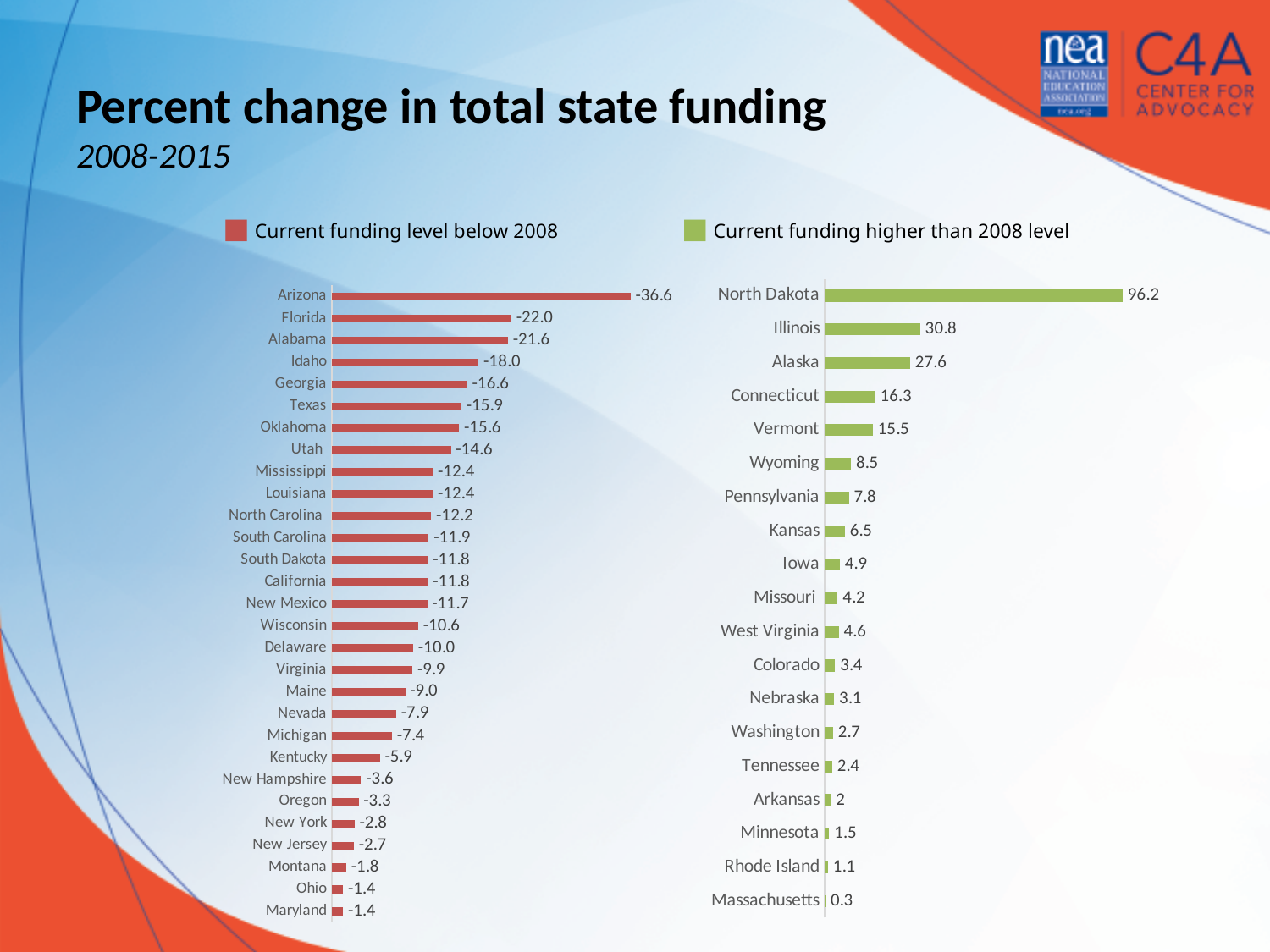
On the right chart (Current funding higher than 2008 level), which state has the lowest value? Massachusetts How many states are shown on the left chart (Current funding level below 2008)? 29 What type of chart is used on the slide? Bar chart On the right chart (Current funding higher than 2008 level), which is larger, Connecticut or Vermont? Connecticut On the right chart (Current funding higher than 2008 level), what is the difference between North Dakota and Illinois? 65.4 On the right chart (Current funding higher than 2008 level), what is the value for Illinois? 30.8 On the right chart (Current funding higher than 2008 level), which state has the highest value? North Dakota On the left chart (Current funding level below 2008), what is the value for Arizona? -36.6 How many states are shown on the right chart (Current funding higher than 2008 level)? 19 On the left chart (Current funding level below 2008), what is the difference between Florida and Alabama? 0.4 On the left chart (Current funding level below 2008), which state has the largest decrease? Arizona On the left chart (Current funding level below 2008), what is the value for Texas? -15.9